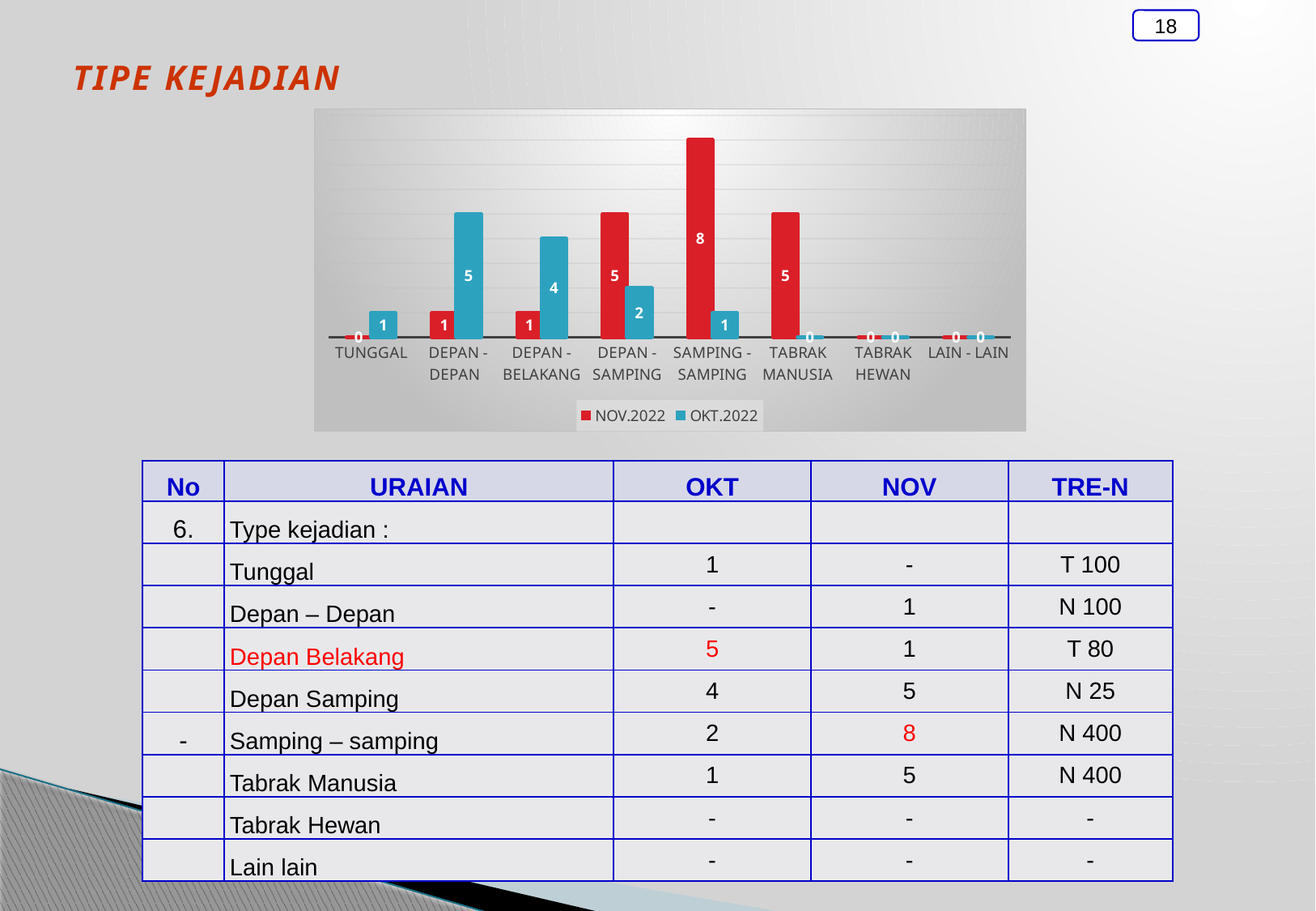
Which category has the highest NOV.2022 value in the chart? SAMPING - SAMPING What is the OKT.2022 value for DEPAN - DEPAN in the chart? 5 What is the difference between the NOV.2022 and OKT.2022 values for SAMPING - SAMPING in the chart? 7 What type of chart is shown on the slide? Bar chart For DEPAN - SAMPING, which series has the larger value in the chart, NOV.2022 or OKT.2022? NOV.2022 Which colour represents the NOV.2022 series in the chart? Red What is the OKT.2022 value for DEPAN - BELAKANG in the chart? 4 How many series does the chart legend list? 2 What is the NOV.2022 value for SAMPING - SAMPING in the chart? 8 Which category has the highest OKT.2022 value in the chart? DEPAN - DEPAN What is the NOV.2022 value for TABRAK MANUSIA in the chart? 5 How many categories are shown on the x axis of the chart? 8